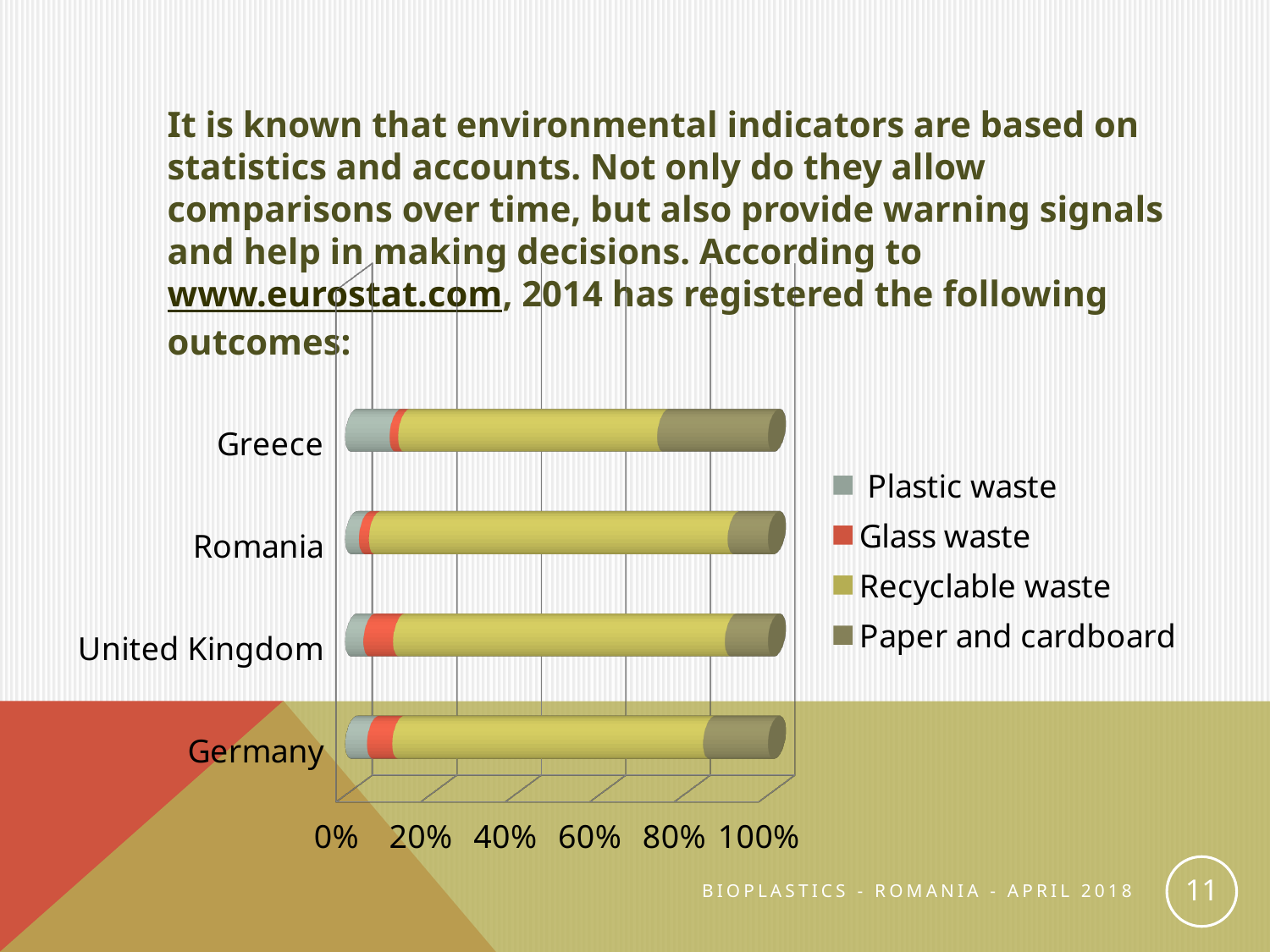
Is the Recyclable waste segment for Greece larger or smaller than the Recyclable waste segment for Romania? smaller Which series is shown in red on the chart? Glass waste What kind of chart is shown on the slide? Stacked bar chart How many series does the chart legend list? 4 How many countries are shown on the chart? 4 Is the Paper and cardboard segment for Greece larger or smaller than the Paper and cardboard segment for Germany? larger Which series is listed first in the chart legend? Plastic waste Which country has the largest Plastic waste segment? Greece Which country has the smallest Recyclable waste segment? Greece Which country has the largest Paper and cardboard segment? Greece Which country has the largest Glass waste segment? United Kingdom